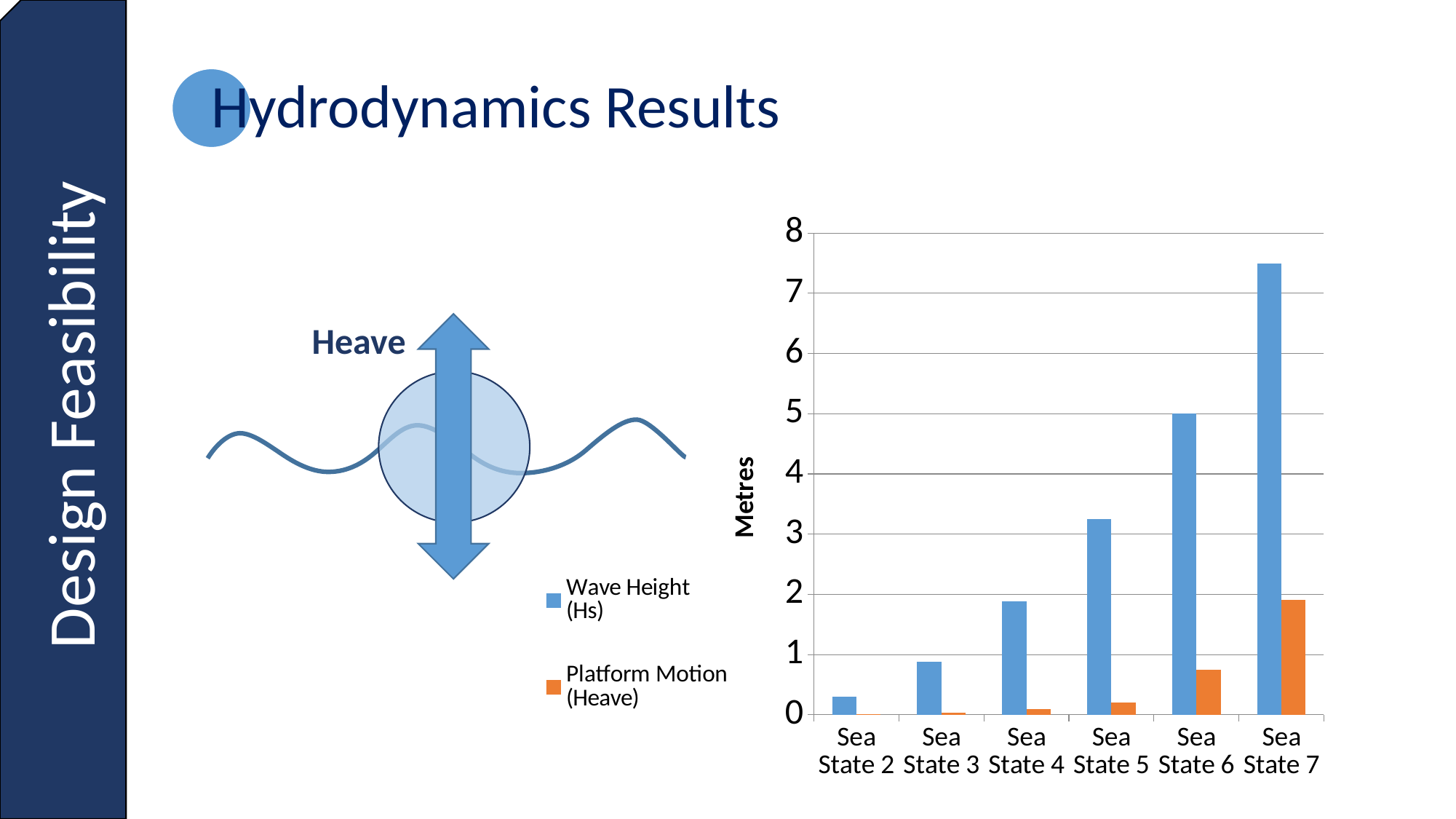
Do the Wave Height (Hs) values rise or fall from Sea State 2 to Sea State 7? rise How many sea state categories are shown on the x axis of the chart? 6 Is the Wave Height (Hs) for Sea State 7 greater or less than 7? greater At Sea State 7, which is larger: Wave Height (Hs) or Platform Motion (Heave)? Wave Height (Hs) What is the label on the chart's vertical axis? Metres Which sea state has the lowest Wave Height (Hs)? Sea State 2 Is the Platform Motion (Heave) for Sea State 7 greater or less than 2? less Is the Wave Height (Hs) for Sea State 3 greater or less than 1? less How many series does the chart's legend list? 2 What kind of chart is shown on the slide? bar chart Which sea state has the highest Wave Height (Hs)? Sea State 7